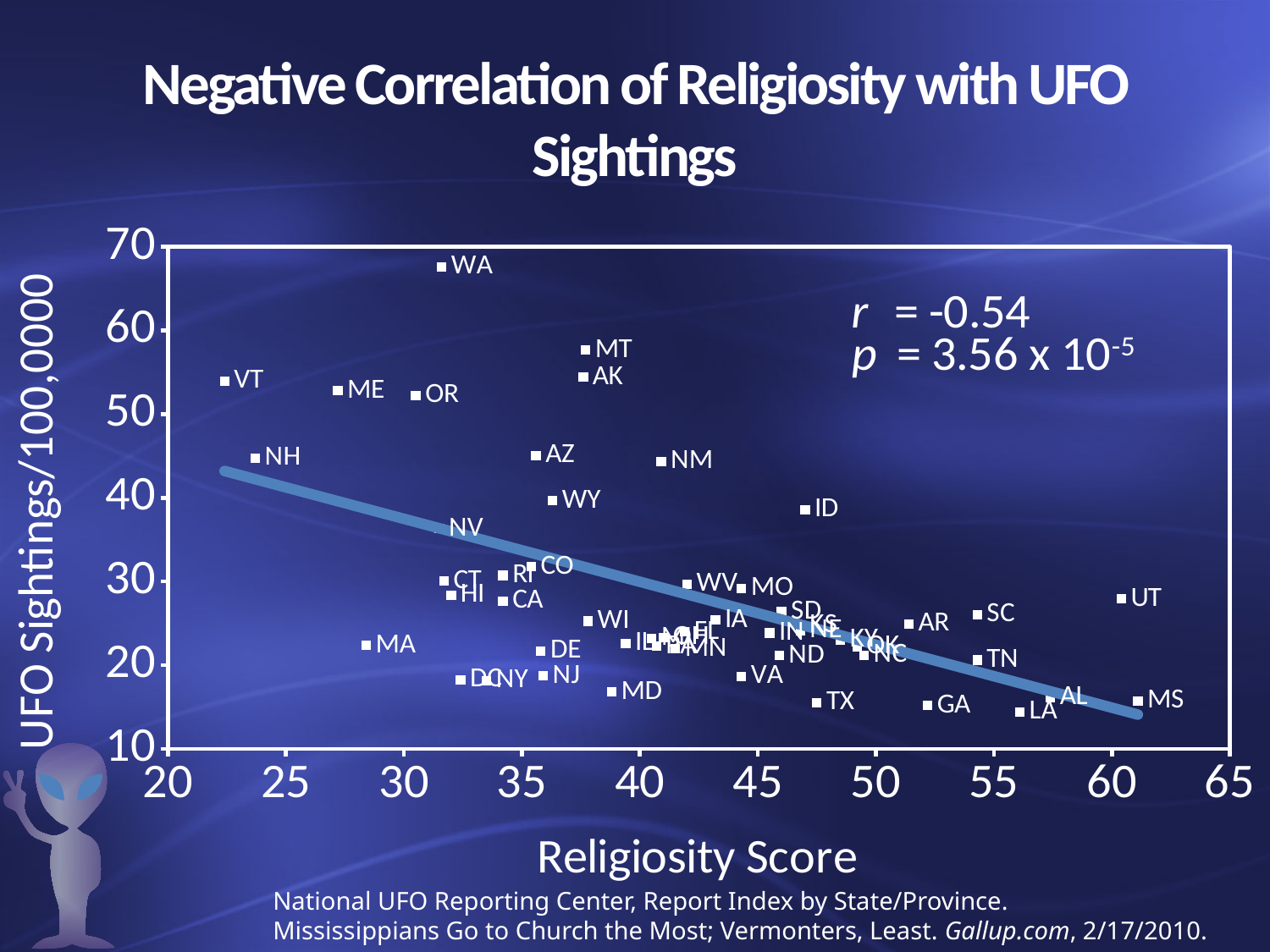
Which state has the highest UFO sightings per 100,000 on the chart? WA Is the religiosity score for MA greater or less than 30? less What p value is printed on the chart? 3.56 x 10^-5 What kind of chart is shown on the slide? scatter plot What is the correlation coefficient r printed on the chart? -0.54 As the religiosity score increases along the x axis, do UFO sightings generally rise or fall? fall Is the UFO sightings value for TX greater or less than 20? less Is the UFO sightings value for MT greater or less than 50? greater What is the title of the x axis? Religiosity Score Which state has the lowest religiosity score on the chart? VT Which has more UFO sightings per 100,000, NH or ID? NH